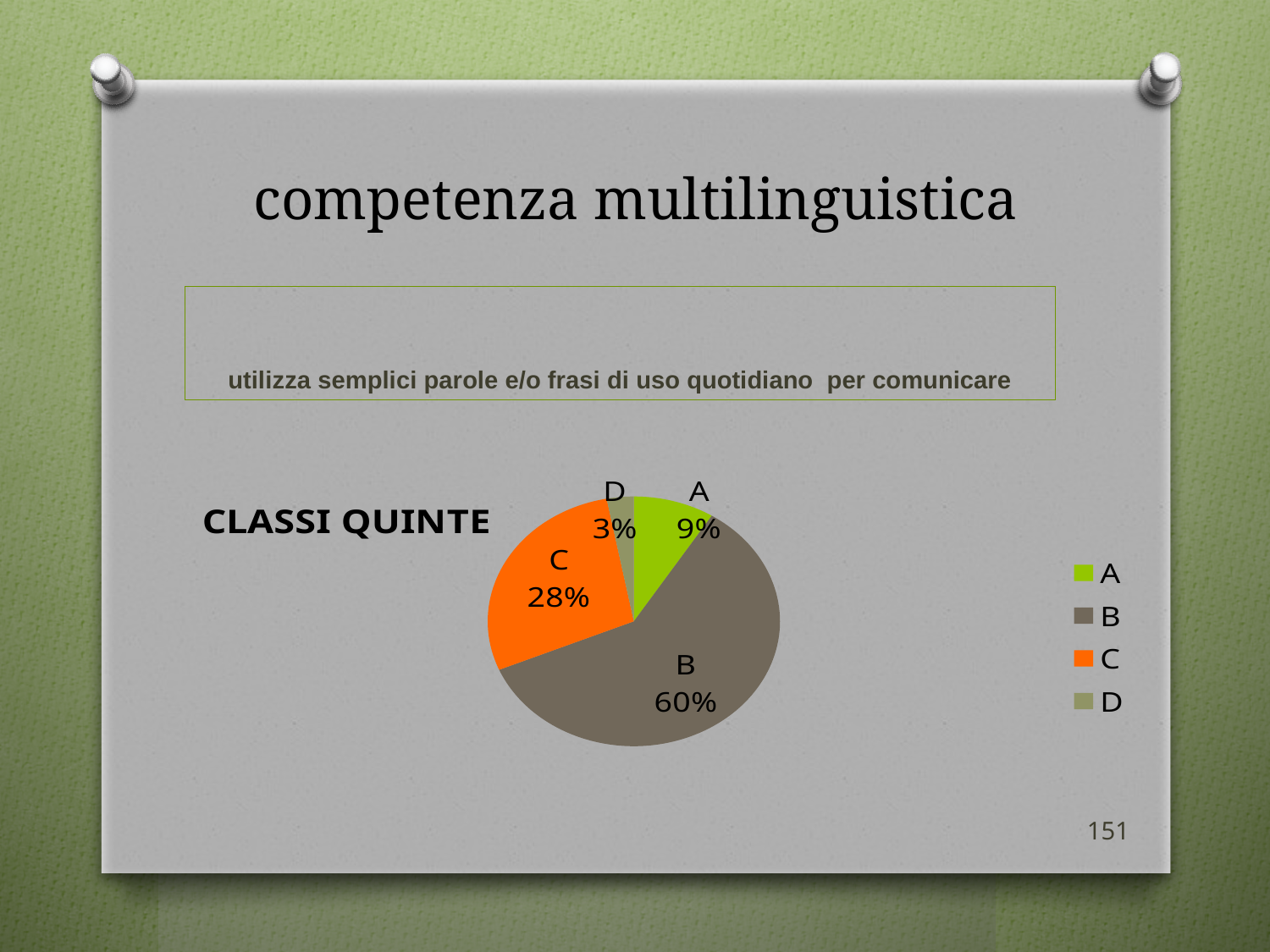
What percentage does slice C represent in the pie chart? 28% What is the difference in percentage points between slice B and slice C? 32 What kind of chart is shown on the slide? pie chart What percentage does slice D represent in the pie chart? 3% Which category has the largest share of the pie chart? B What percentage does slice A represent in the pie chart? 9% What percentage does slice B represent in the pie chart? 60% What colour is slice C in the pie chart? orange Which category has the smallest share of the pie chart? D Which is larger, slice A or slice C? C How many slices does the pie chart have? 4 How many entries does the legend list? 4